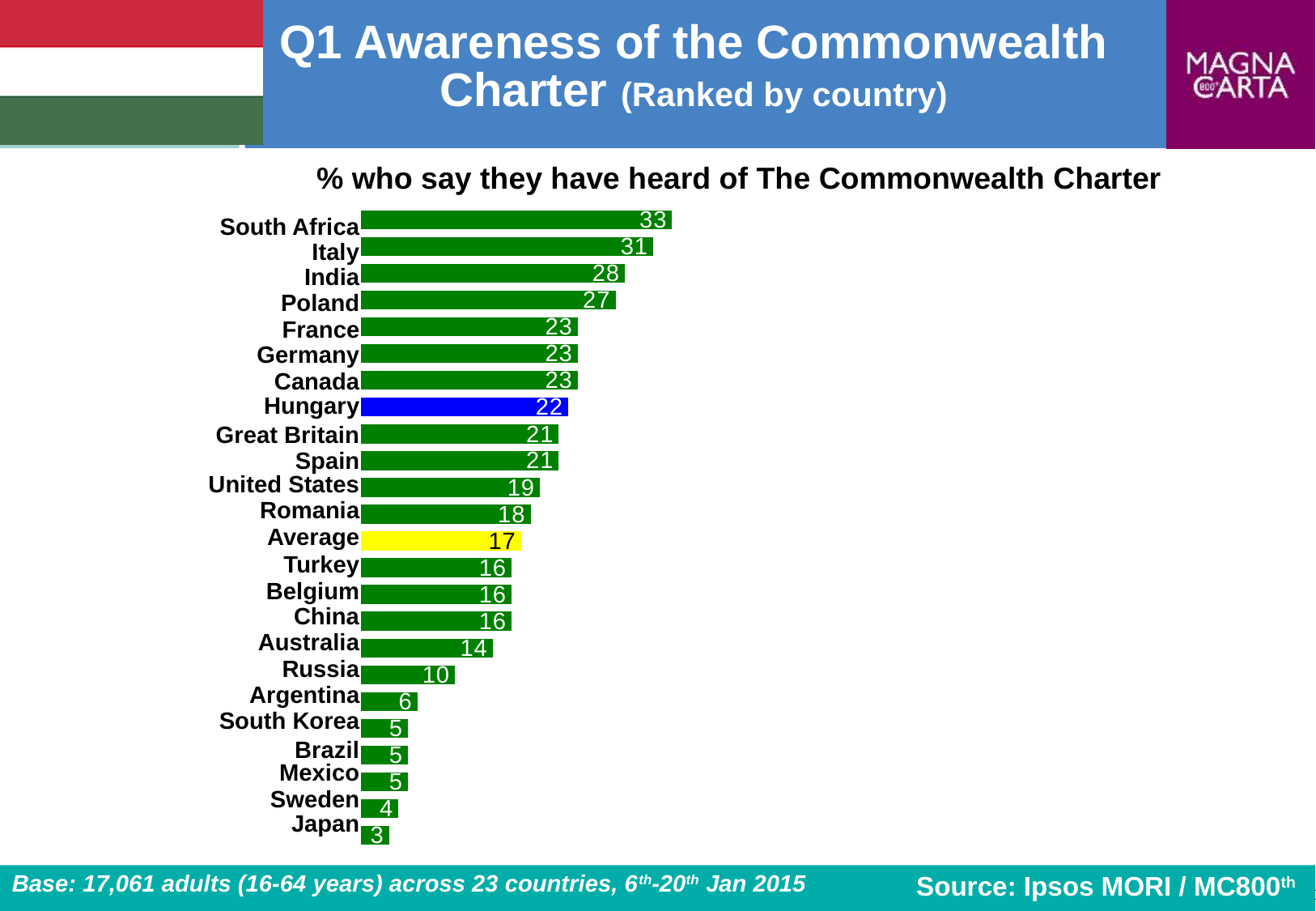
What is the difference between the value for Hungary and the Average? 5 What is the Average value shown on the chart? 17 How many bars are shown on the chart, including the Average? 24 Which country has the highest percentage who say they have heard of The Commonwealth Charter? South Africa Which bar on the chart is coloured yellow? Average What type of chart is shown on the slide? Bar chart What is the value shown for Hungary? 22 What is the value shown for Japan? 3 Which has a higher value, Russia or Australia? Australia Which country has the lowest percentage who say they have heard of The Commonwealth Charter? Japan What percentage of respondents in South Africa say they have heard of The Commonwealth Charter? 33 What is the difference between the values for Italy and India? 3